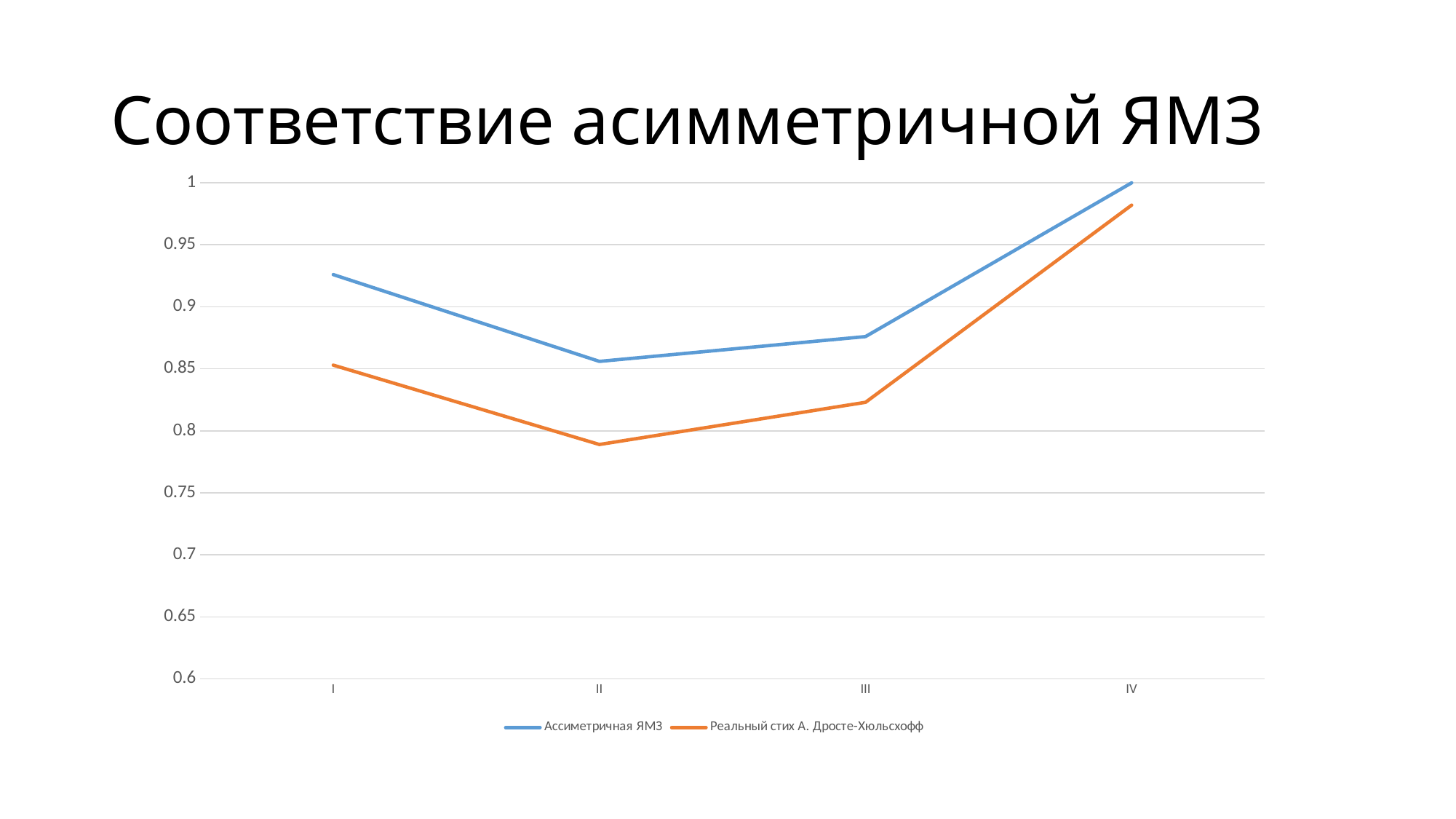
Is the value for Ассиметричная ЯМЗ at I greater or less than 0.9? greater How many series does the legend list? 2 How many categories are shown on the x axis? 4 Do the values of the Реальный стих А. Дросте-Хюльсхофф series rise or fall from II to IV? rise At which category is the Реальный стих А. Дросте-Хюльсхофф series highest? IV Is the value for Реальный стих А. Дросте-Хюльсхофф at II greater or less than 0.8? less At which category is the Ассиметричная ЯМЗ series lowest? II What is the value of the Ассиметричная ЯМЗ series at IV? 1 At which category is the Реальный стих А. Дросте-Хюльсхофф series lowest? II What is the title of the slide? Соответствие асимметричной ЯМЗ Which series has the higher value at II, Ассиметричная ЯМЗ or Реальный стих А. Дросте-Хюльсхофф? Ассиметричная ЯМЗ What kind of chart is shown on the slide? line chart